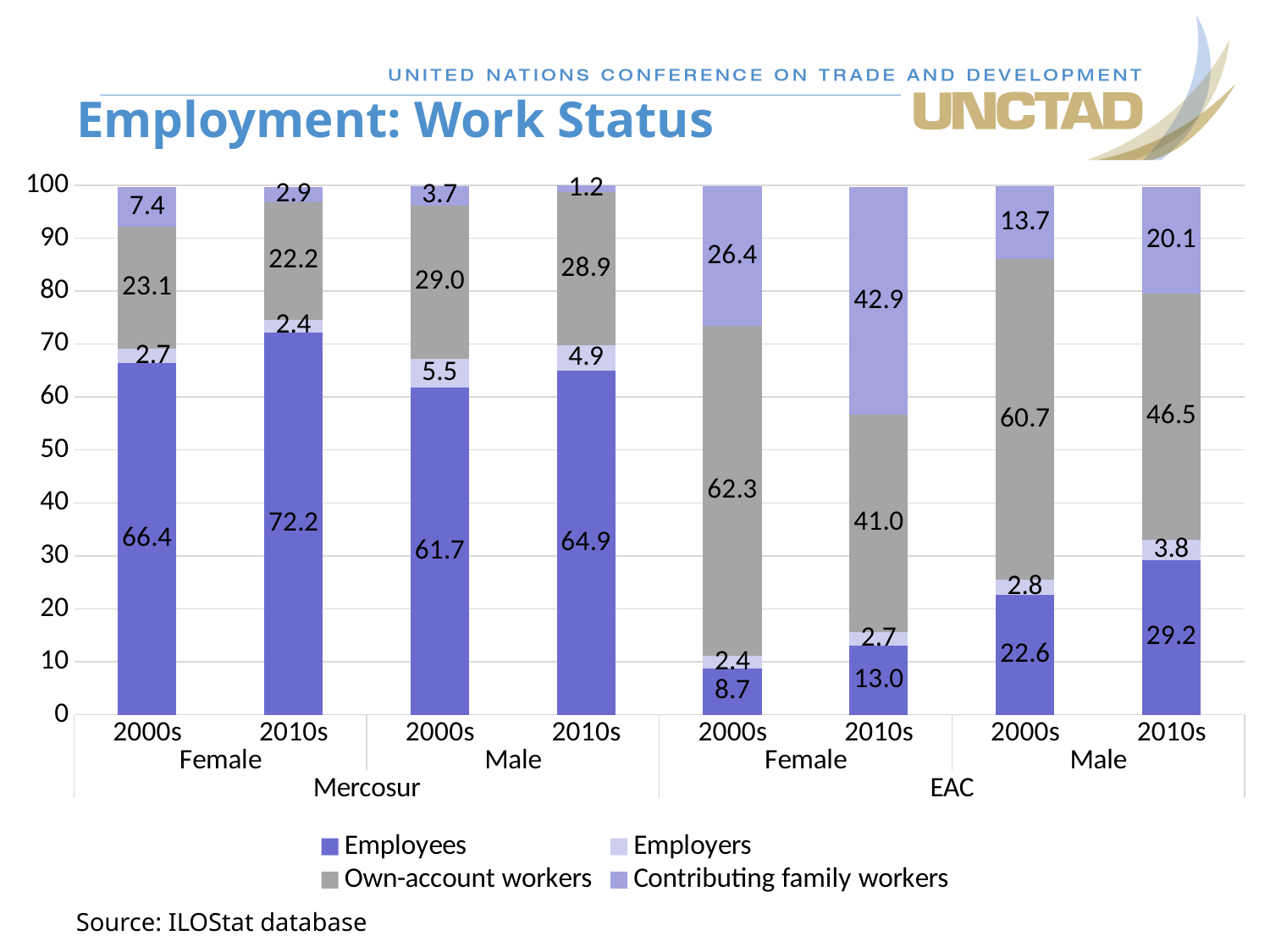
Which bar has the highest Employees value? Mercosur Female 2010s What is the Contributing family workers value for EAC Female in the 2010s? 42.9 Which bar has the lowest Employees value? EAC Female 2000s What kind of chart is shown on the slide? Stacked bar chart What is the source cited for the chart? ILOStat database What is the difference between the Employees values for Mercosur Female in the 2010s and the 2000s? 5.8 How many bars are plotted in the chart? 8 How many series does the legend list? 4 What is the Employees value for Mercosur Female in the 2010s? 72.2 What is the Employers value for Mercosur Male in the 2000s? 5.5 What is the Own-account workers value for EAC Female in the 2000s? 62.3 Which is larger for EAC Male in the 2010s: Own-account workers or Contributing family workers? Own-account workers